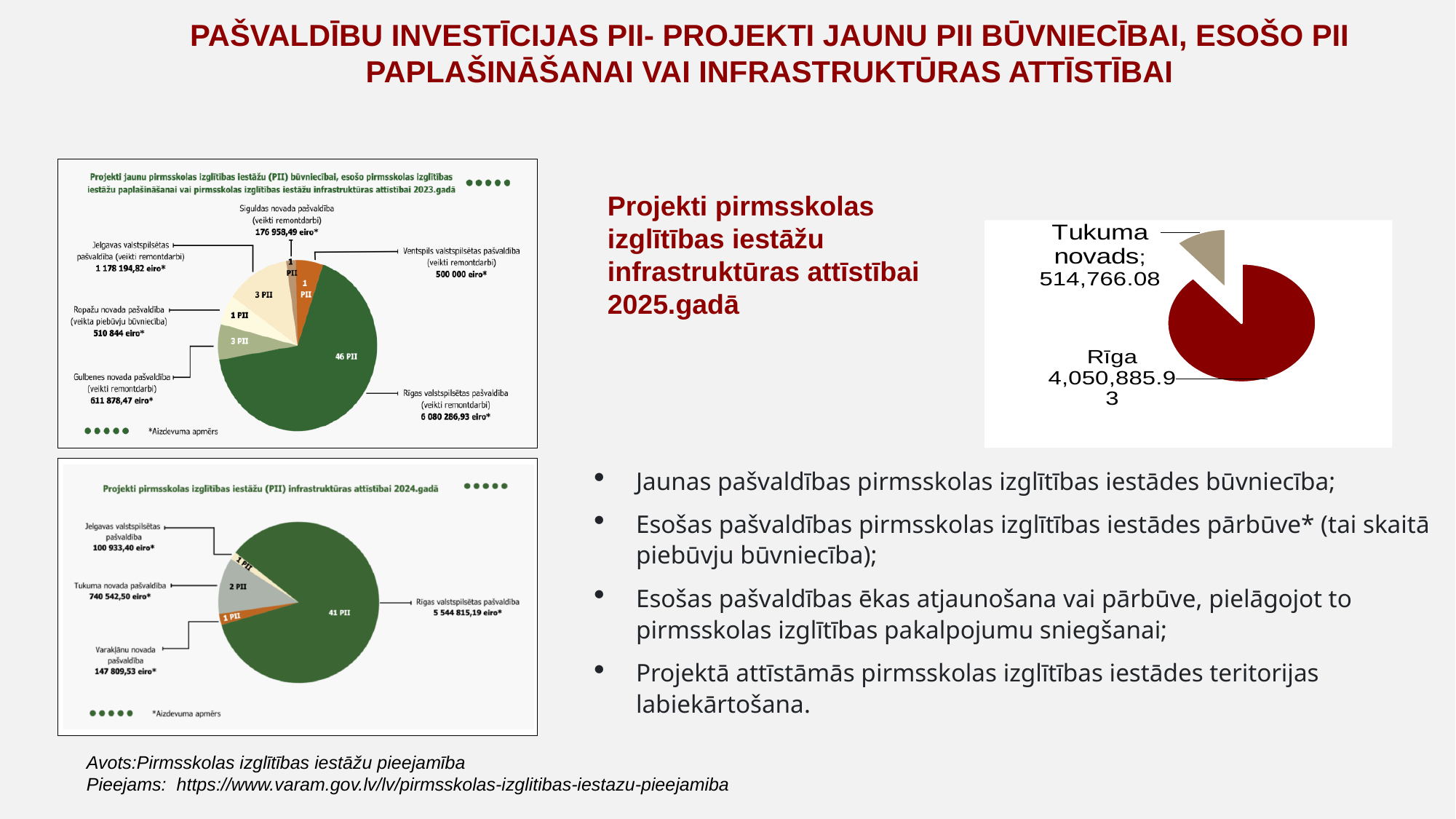
On the 2025 pie chart on the right, what is the value for Rīga? 4,050,885.93 On the 2023 chart (top left), how many PII does the Rīgas valstspilsētas pašvaldība slice represent? 46 PII On the 2025 pie chart on the right, which category has the larger slice? Rīga On the 2025 pie chart on the right, what is the value for Tukuma novads? 514,766.08 On the 2023 chart (top left), what is the amount shown for Ventspils valstspilsētas pašvaldība? 500 000 eiro* On the 2024 chart (bottom left), how many PII does the Rīgas valstspilsētas pašvaldība slice represent? 41 PII On the 2023 chart (top left), which municipality has the smallest amount? Siguldas novada pašvaldība What type of chart is the 2025 chart on the right of the slide? Pie chart On the 2023 chart (top left), how many municipalities (slices) are shown? 6 On the 2024 chart (bottom left), which has the larger amount: Jelgavas valstspilsētas pašvaldība or Varakļānu novada pašvaldība? Varakļānu novada pašvaldība How many slices does the 2025 pie chart on the right have? 2 On the 2024 chart (bottom left), what is the amount shown for Tukuma novada pašvaldība? 740 542,50 eiro*